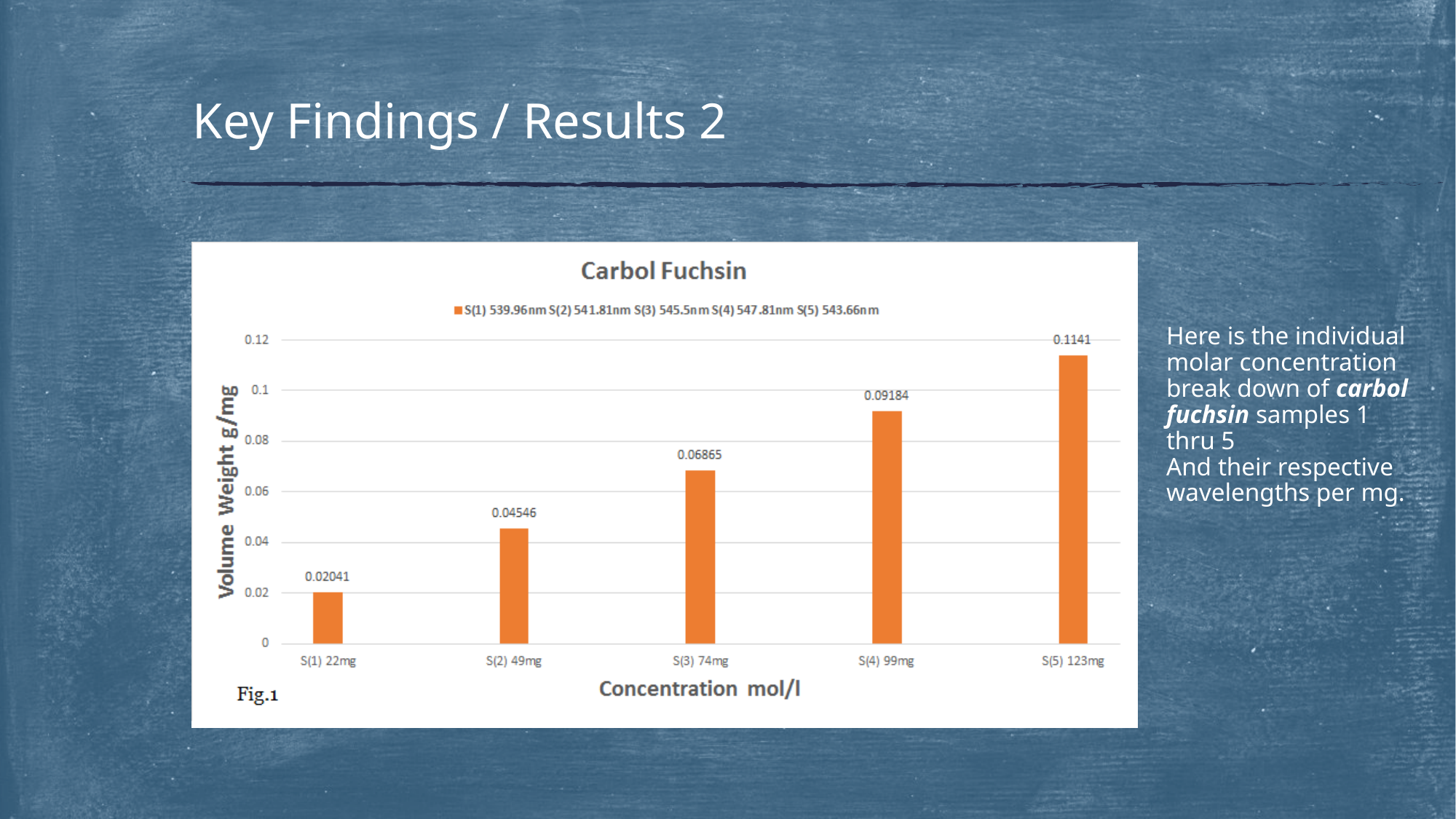
Which category has the highest value in the Carbol Fuchsin chart? S(5) 123mg What is the value for S(1) 22mg in the Carbol Fuchsin chart? 0.02041 Which category has the lowest value in the Carbol Fuchsin chart? S(1) 22mg What type of chart is shown on the slide? Bar chart Do the values rise or fall from S(1) 22mg to S(5) 123mg? Rise How many bars are plotted in the Carbol Fuchsin chart? 5 What is the difference between the values for S(4) 99mg and S(3) 74mg? 0.02319 Is the value for S(4) 99mg greater or less than 0.08? greater What is the value for S(3) 74mg in the Carbol Fuchsin chart? 0.06865 What is the difference between the values for S(5) 123mg and S(1) 22mg? 0.09369 Which is larger, the value for S(2) 49mg or the value for S(4) 99mg? S(4) 99mg What is the value for S(5) 123mg in the Carbol Fuchsin chart? 0.1141